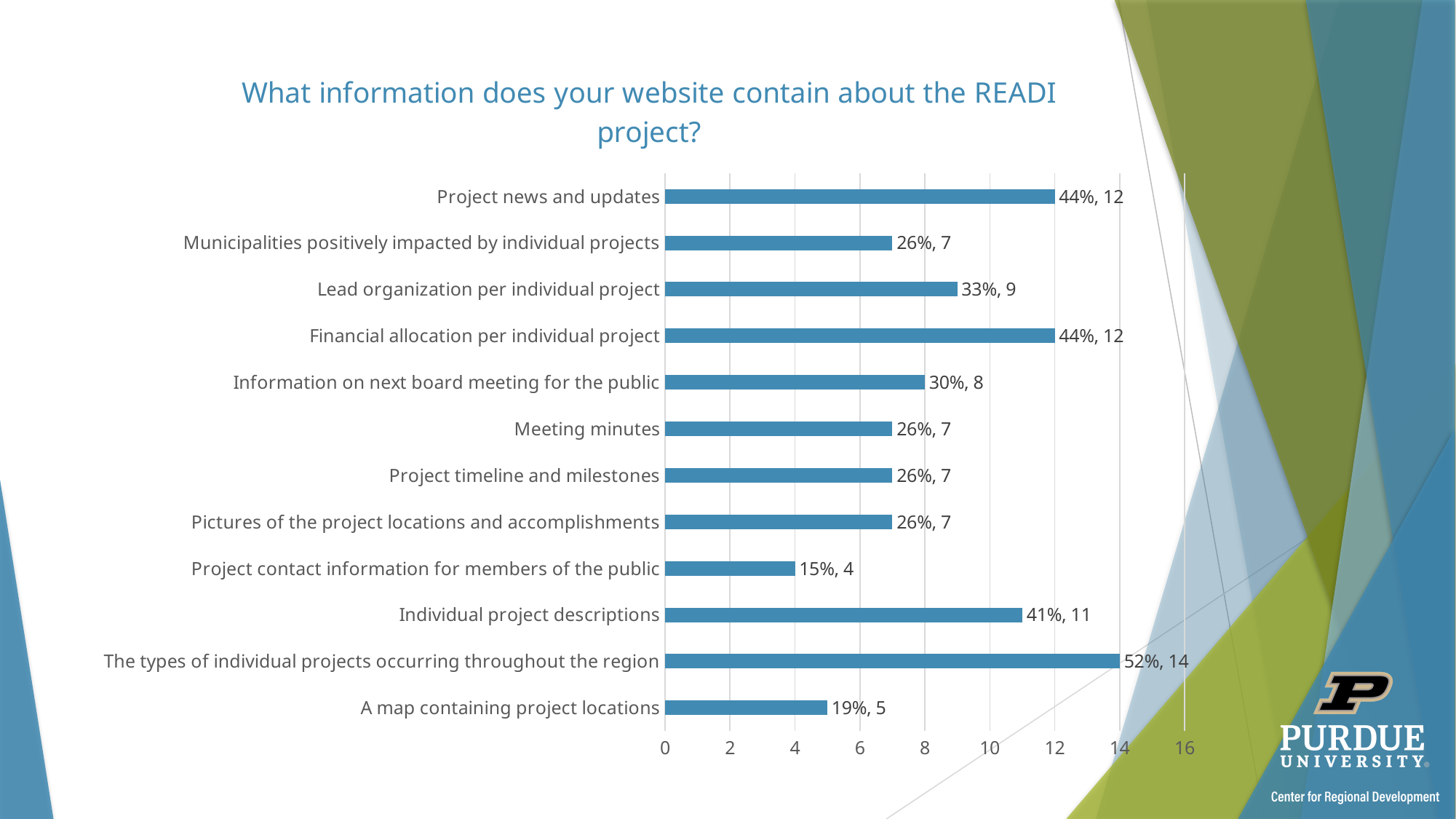
Which category has the lowest value? Project contact information for members of the public What percentage is shown for "Individual project descriptions"? 41% What is the title of the chart? What information does your website contain about the READI project? Which is larger: "Lead organization per individual project" or "Information on next board meeting for the public"? Lead organization per individual project How many categories are shown in the chart? 12 Is the value for "Individual project descriptions" greater or less than 10? greater How many respondents reported "A map containing project locations"? 5 What is the data label for "Project news and updates"? 44%, 12 What kind of chart is shown on the slide? Bar chart What is the maximum value shown on the x axis? 16 Which category has the highest value? The types of individual projects occurring throughout the region What is the difference in count between "The types of individual projects occurring throughout the region" and "Project contact information for members of the public"? 10